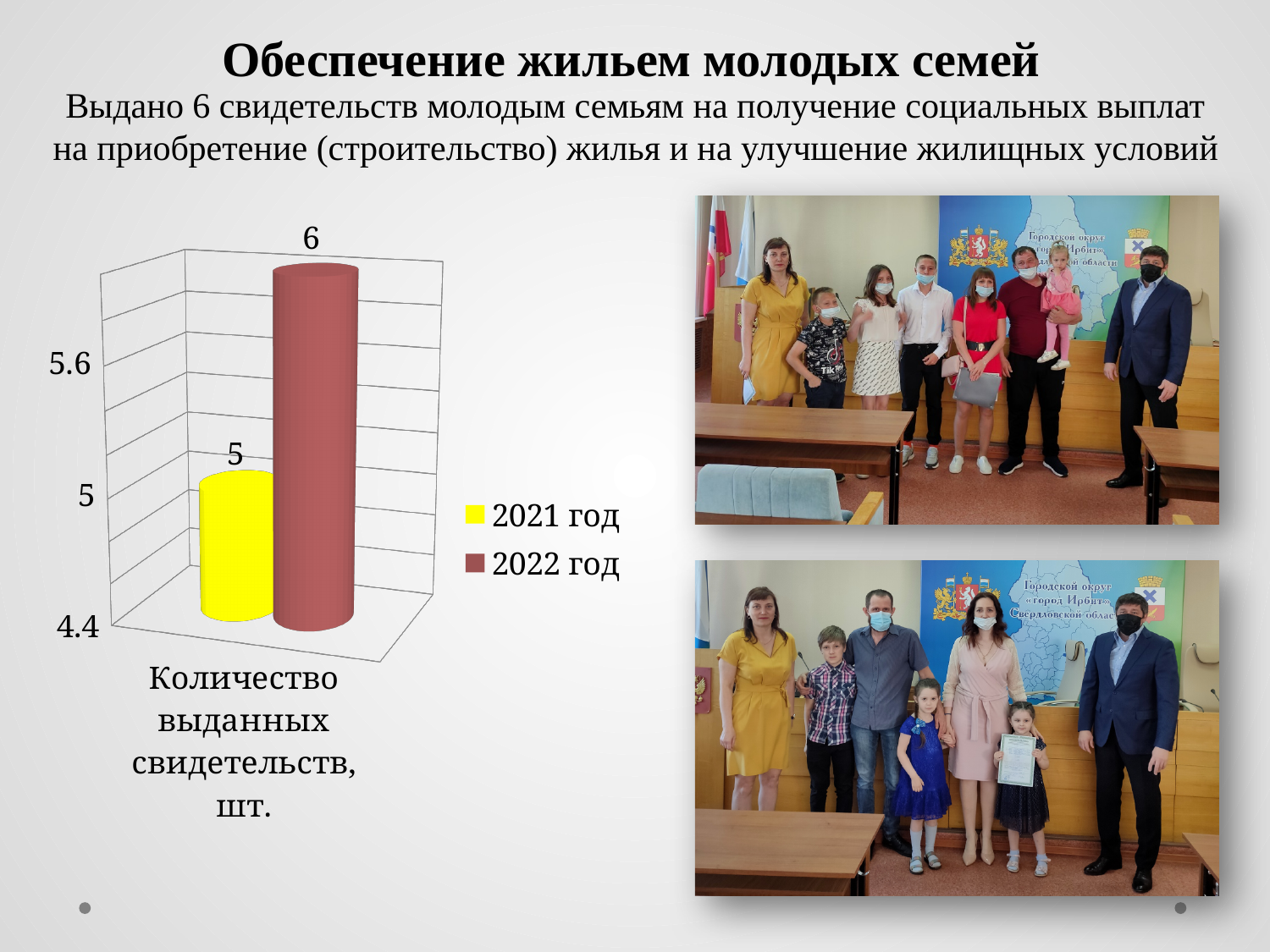
What is the category label shown under the bars? Количество выданных свидетельств, шт. What kind of chart is shown on the slide? bar chart What colour is the bar for 2021 год? yellow What is the value for 2021 год in the chart? 5 What is the difference between the values for 2022 год and 2021 год? 1 Is the value for 2021 год greater or less than 5.6? less How many series does the legend list? 2 What is the value for 2022 год in the chart? 6 Which series has the highest value in the chart? 2022 год Which series has the lowest value in the chart? 2021 год Which series has the higher value, 2021 год or 2022 год? 2022 год Is the value for 2022 год greater or less than 5.6? greater